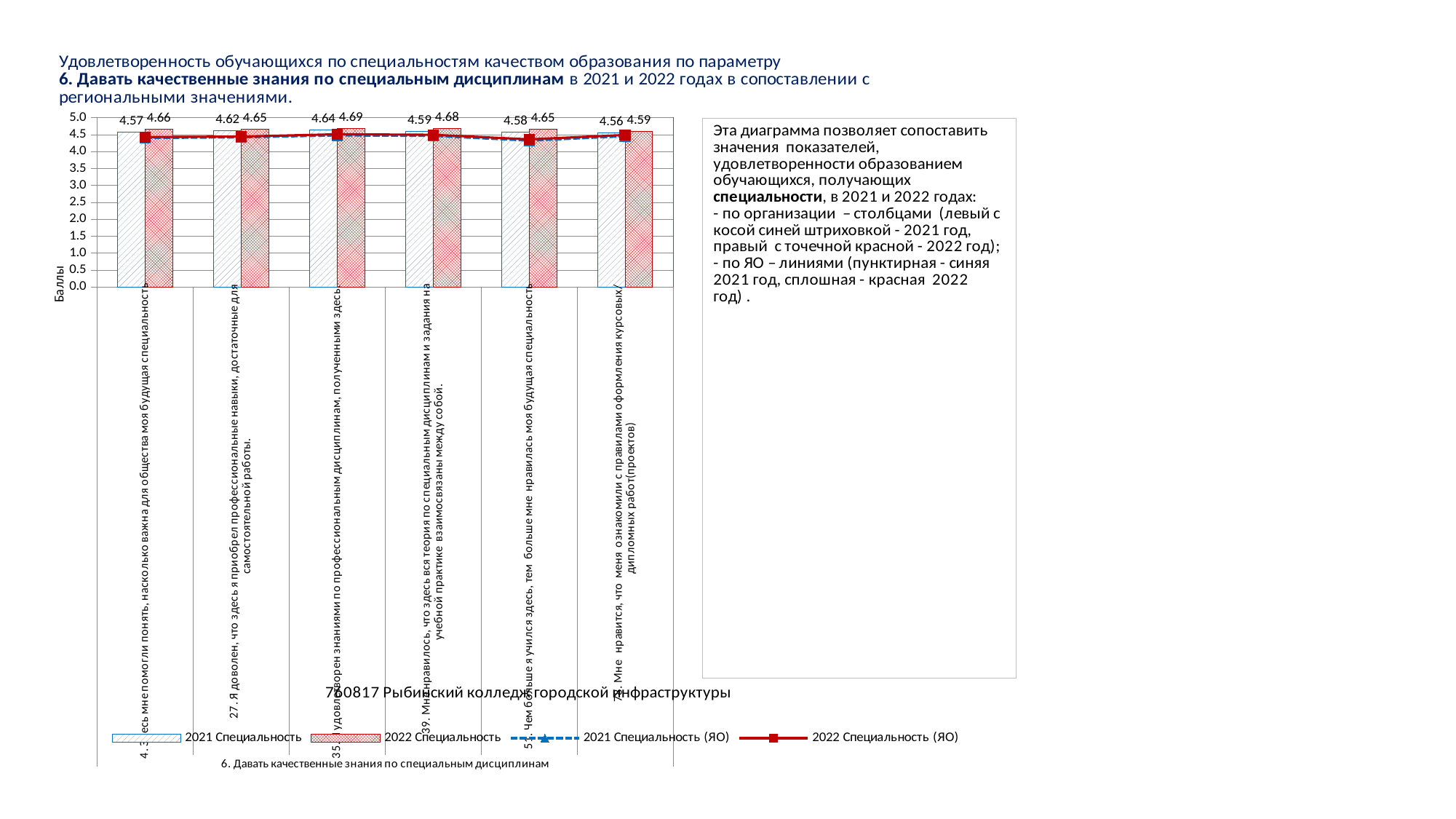
What is the 2022 Специальность value for the third category ("Удовлетворен знаниями по профессиональным дисциплинам, полученными здесь")? 4.69 What is the difference between the 2022 and 2021 Специальность values for the fourth category ("Мне нравилось, что здесь вся теория по специальным дисциплинам и задания на учебной практике взаимосвязаны между собой")? 0.09 How many categories (questions) are plotted along the x axis? 6 Which category has the highest 2022 Специальность value? Удовлетворен знаниями по профессиональным дисциплинам, полученными здесь (third category) Is the 2021 Специальность value for the fifth category ("Чем больше я учился здесь, тем больше мне нравилась моя будущая специальность") greater or less than 4.0? greater What is the 2022 Специальность value for the last category ("Мне нравится, что меня ознакомили с правилами оформления курсовых/дипломных работ")? 4.59 What is the 2021 Специальность value for the first category ("Здесь мне помогли понять, насколько важна для общества моя будущая специальность")? 4.57 Which category has the lowest 2021 Специальность value? Мне нравится, что меня ознакомили с правилами оформления курсовых/дипломных работ (last category) For the second category ("Я доволен, что здесь я приобрел профессиональные навыки..."), which is larger: the 2021 or the 2022 Специальность value? 2022 (4.65) What kind of chart is shown on the slide? Combined bar and line chart How many series does the legend list? 4 What is the label of the vertical axis? Баллы